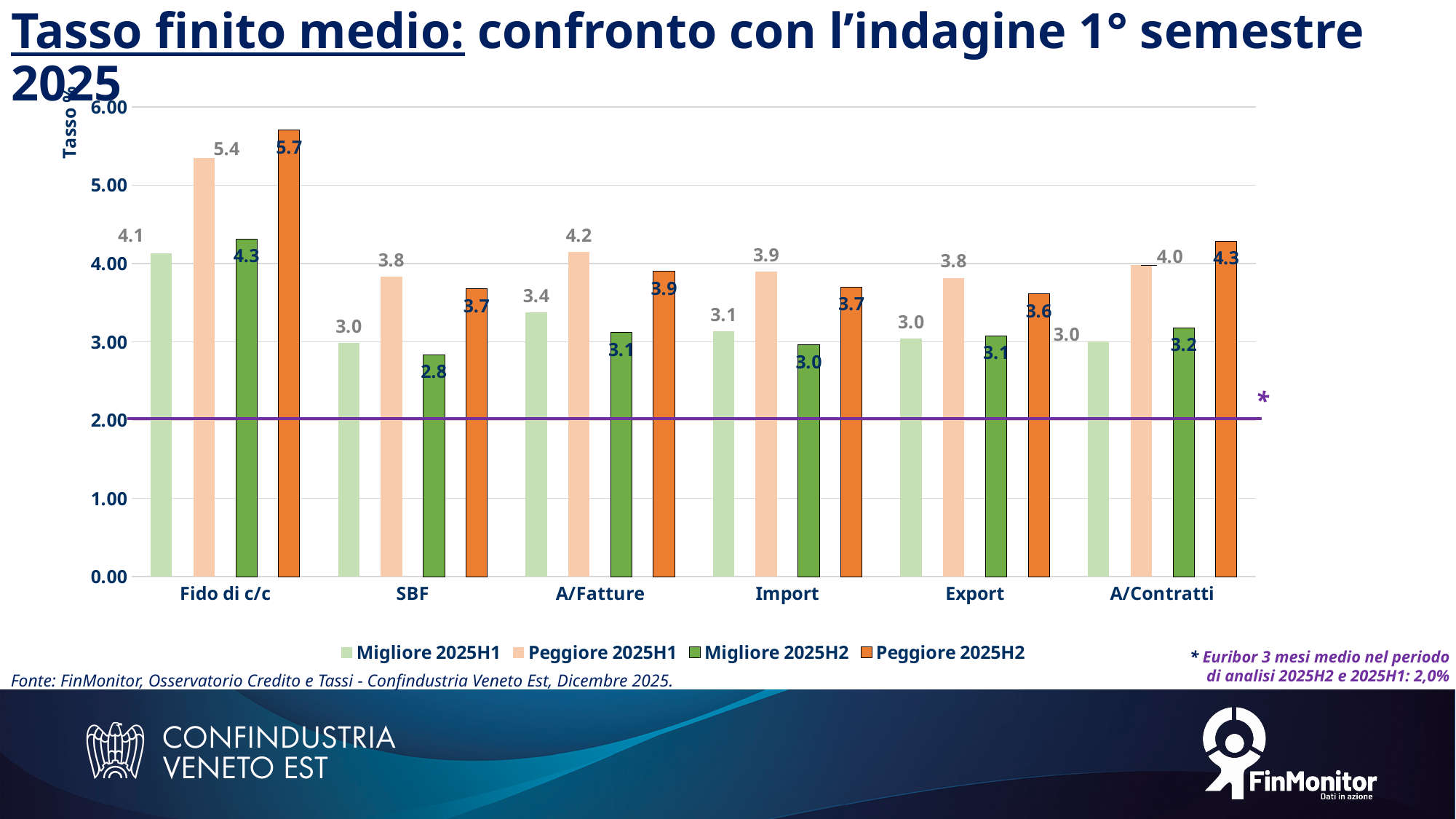
What is the value of Migliore 2025H2 for SBF? 2.8 What is the value of Migliore 2025H1 for Import? 3.1 How many categories are shown on the x axis? 6 How many series does the legend list? 4 At what value is the horizontal purple reference line drawn? 2.00 What is the value of Peggiore 2025H2 for Fido di c/c? 5.7 What is the difference between Peggiore 2025H2 and Migliore 2025H2 for A/Contratti? 1.1 What is the value of Peggiore 2025H1 for A/Fatture? 4.2 Which category has the highest Peggiore 2025H2 value? Fido di c/c What kind of chart is shown on the slide? Bar chart Which category has the lowest Migliore 2025H2 value? SBF Which is larger for Export: Peggiore 2025H1 or Peggiore 2025H2? Peggiore 2025H1